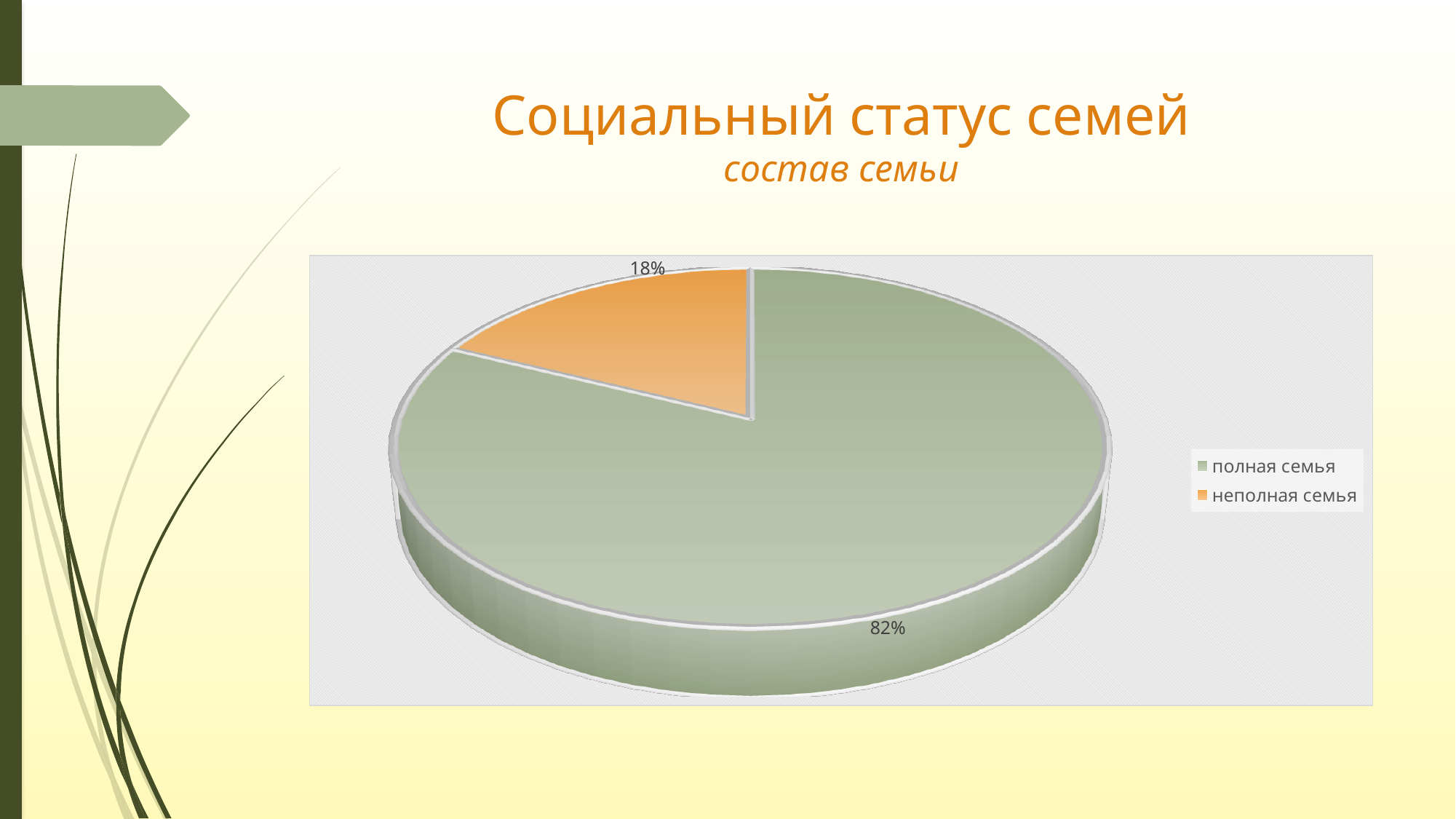
What is the difference in percentage points between "полная семья" and "неполная семья"? 64 Which category has the smallest slice of the pie? неполная семья What is the title of the slide above the chart? Социальный статус семей What share of the pie does "неполная семья" represent? 18% How many entries does the legend list? 2 Which is larger: the slice for "полная семья" or the slice for "неполная семья"? полная семья What kind of chart is shown on the slide? pie chart What share of the pie does "полная семья" represent? 82% What colour is the slice for "неполная семья"? orange How many slices does the pie chart have? 2 Which category has the largest slice of the pie? полная семья